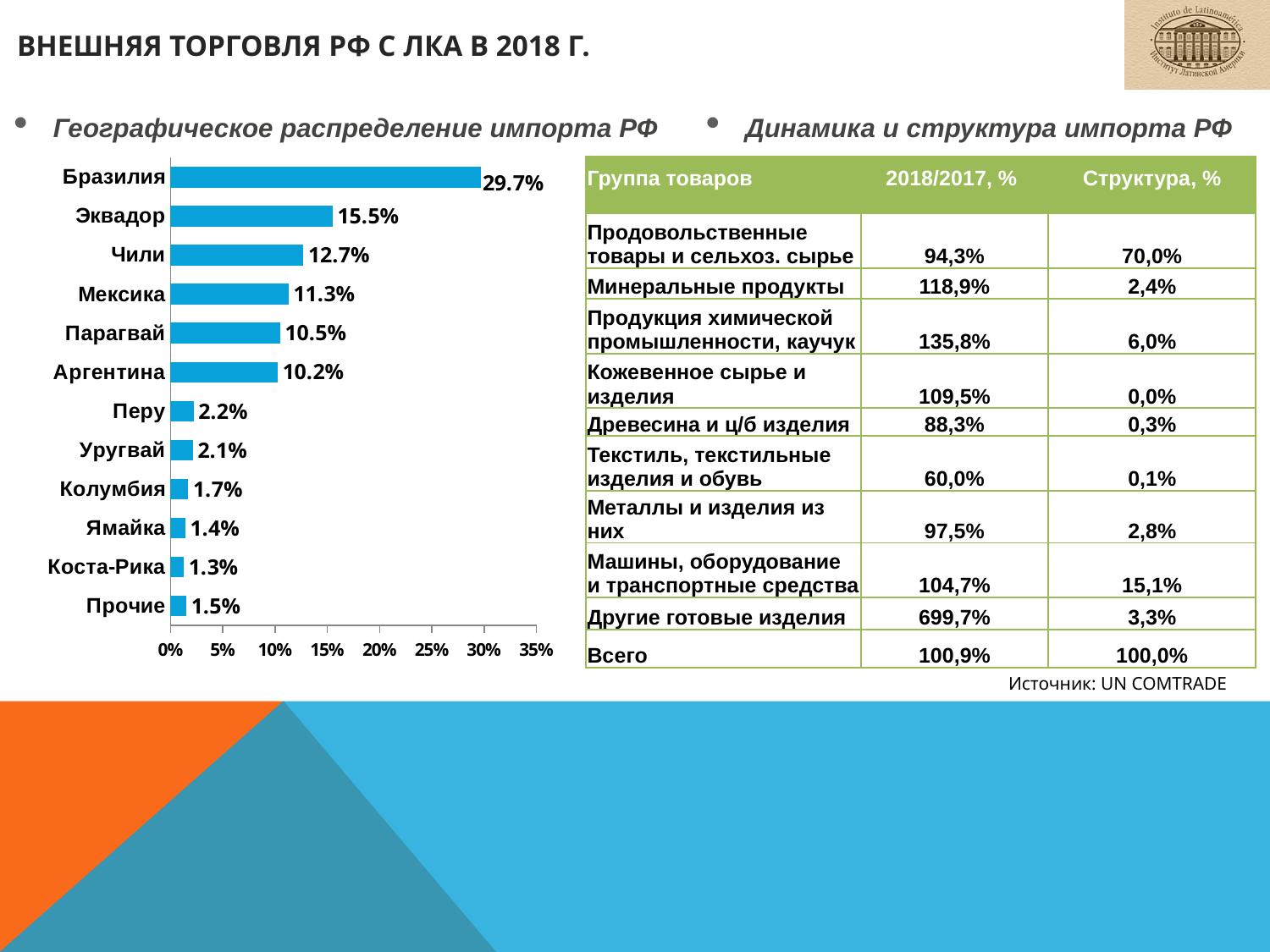
Which category has the lowest value in the bar chart? Коста-Рика Which is larger in the bar chart, Парагвай or Аргентина? Парагвай What is the difference between the values for Бразилия and Эквадор in the bar chart? 14.2% What is the value for Колумбия in the bar chart? 1.7% What is the title of the bar chart on the left? Географическое распределение импорта РФ How many categories are shown in the bar chart? 12 What is the value for Бразилия in the bar chart? 29.7% What is the value for Мексика in the bar chart? 11.3% What is the difference between the values for Перу and Уругвай in the bar chart? 0.1% Which country has the highest share in the bar chart? Бразилия Is the value for Чили in the bar chart greater or less than 10%? greater What kind of chart is used for the geographic distribution of imports? bar chart